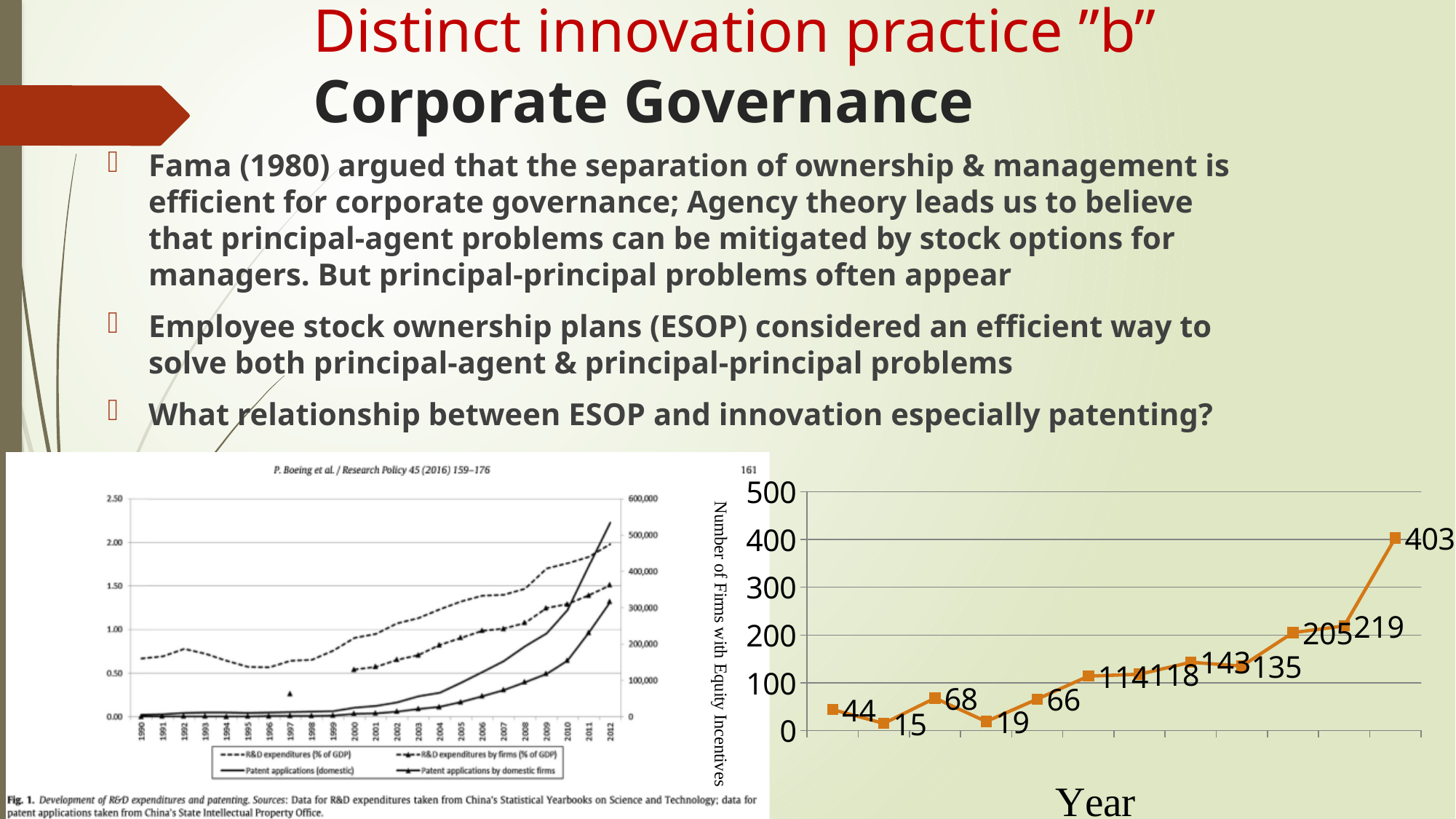
In the left-hand chart (Fig. 1, Development of R&D expenditures and patenting), is the value of R&D expenditures (% of GDP) in 1990 greater or less than 1.00? less In the right-hand chart (Number of Firms with Equity Incentives), what is the value of the first data point on the left? 44 In the right-hand chart (Number of Firms with Equity Incentives), what is the difference between the highest value (403) and the second-highest value (219)? 184 In the right-hand chart (Number of Firms with Equity Incentives), how many data points are plotted? 12 In the right-hand chart (Number of Firms with Equity Incentives), what is the highest value plotted? 403 In the left-hand chart (Fig. 1, Development of R&D expenditures and patenting), how many series does the legend list? 4 In the right-hand chart (Number of Firms with Equity Incentives), what is the label on the x axis? Year In the right-hand chart (Number of Firms with Equity Incentives), what is the difference between the highest value (403) and the lowest value (15)? 388 In the right-hand chart (Number of Firms with Equity Incentives), what is the lowest value plotted? 15 In the left-hand chart (Fig. 1, Development of R&D expenditures and patenting), is the value of Patent applications (domestic) in 2012 greater or less than 400,000? greater In the right-hand chart (Number of Firms with Equity Incentives), do the values generally rise or fall from left to right along the Year axis? Rise What kind of chart is the right-hand chart showing Number of Firms with Equity Incentives? Line chart